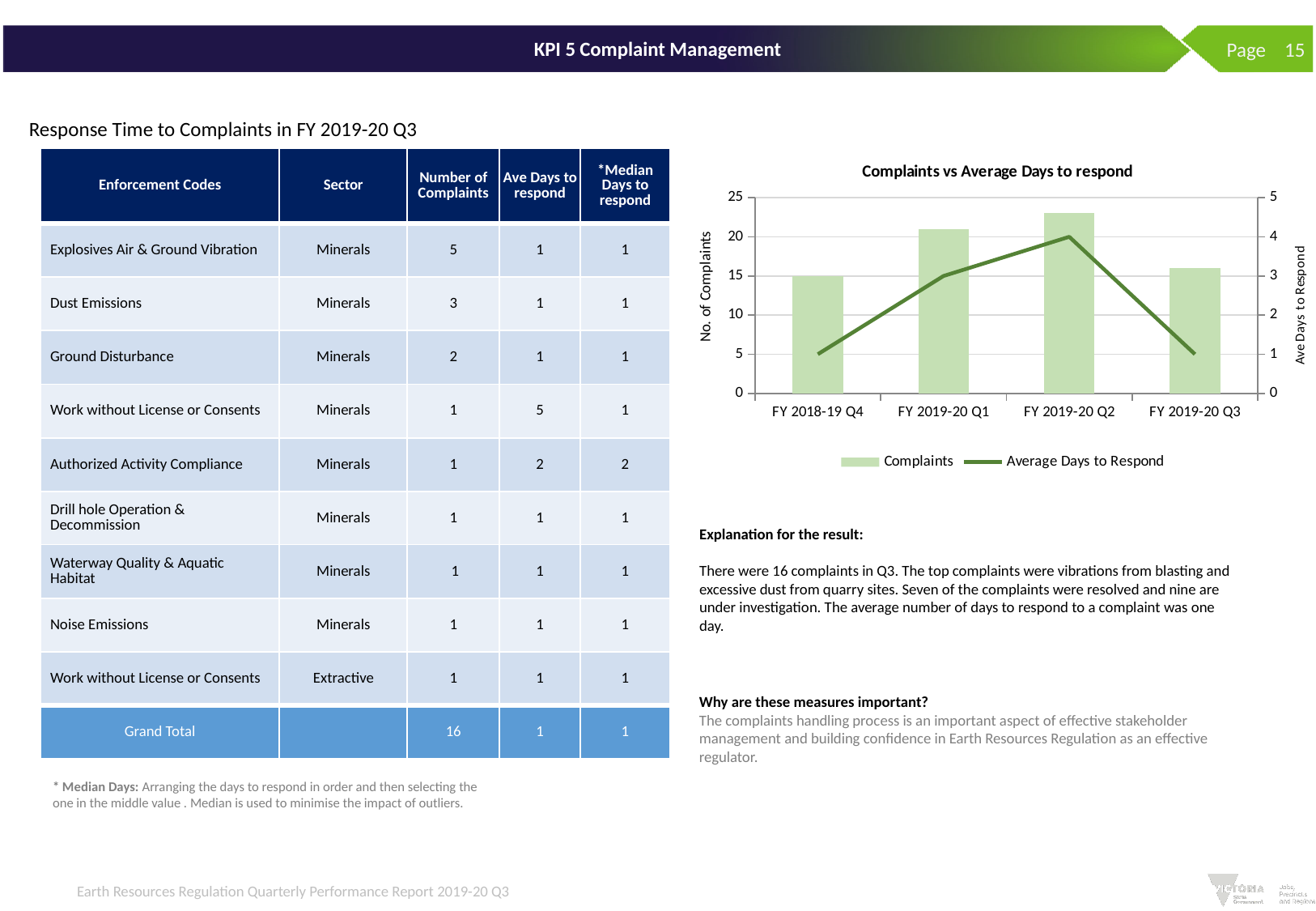
In the 'Complaints vs Average Days to respond' chart, what is the Average Days to Respond for FY 2019-20 Q1? 3 In the 'Complaints vs Average Days to respond' chart, which quarter has the highest number of complaints? FY 2019-20 Q2 In the 'Complaints vs Average Days to respond' chart, is the number of complaints for FY 2019-20 Q1 greater or less than 20? greater In the 'Complaints vs Average Days to respond' chart, what is the difference in Average Days to Respond between FY 2019-20 Q2 and FY 2019-20 Q1? 1 In the 'Complaints vs Average Days to respond' chart, which quarter has the highest Average Days to Respond? FY 2019-20 Q2 In the 'Complaints vs Average Days to respond' chart, how many complaints were there in FY 2018-19 Q4? 15 In the 'Complaints vs Average Days to respond' chart, what is the Average Days to Respond for FY 2019-20 Q2? 4 How many quarters are shown on the x axis of the 'Complaints vs Average Days to respond' chart? 4 How many series does the legend of the 'Complaints vs Average Days to respond' chart list? 2 In the 'Complaints vs Average Days to respond' chart, is the number of complaints for FY 2019-20 Q3 greater or less than 20? less What kind of chart is 'Complaints vs Average Days to respond'? A combined bar and line chart In the 'Complaints vs Average Days to respond' chart, which quarter has more complaints, FY 2019-20 Q1 or FY 2019-20 Q3? FY 2019-20 Q1